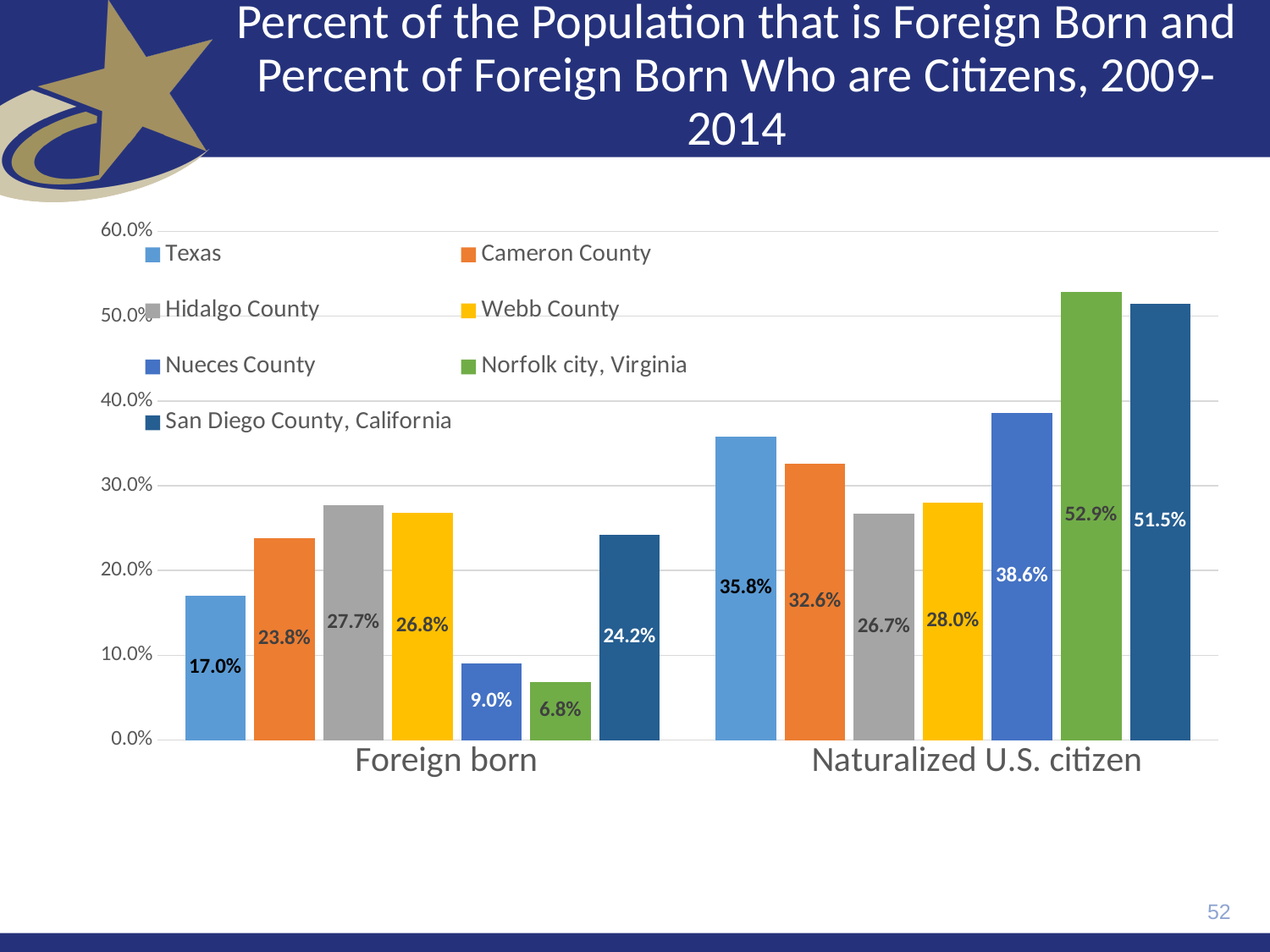
What is the Foreign born value for Nueces County? 9.0% What is the Foreign born value for Hidalgo County? 27.7% Which series has the highest Naturalized U.S. citizen value? Norfolk city, Virginia Which series has the lowest Foreign born value? Norfolk city, Virginia How many categories are shown on the x axis? 2 What kind of chart is shown on the slide? Bar chart Which series has the lowest Naturalized U.S. citizen value? Hidalgo County Is the Naturalized U.S. citizen value for Texas greater or less than 30.0%? greater How many series does the legend list? 7 What is the Naturalized U.S. citizen value for Norfolk city, Virginia? 52.9% Which is larger for Foreign born: Cameron County or San Diego County, California? San Diego County, California What is the difference between the Naturalized U.S. citizen values for Nueces County and Texas? 2.8%